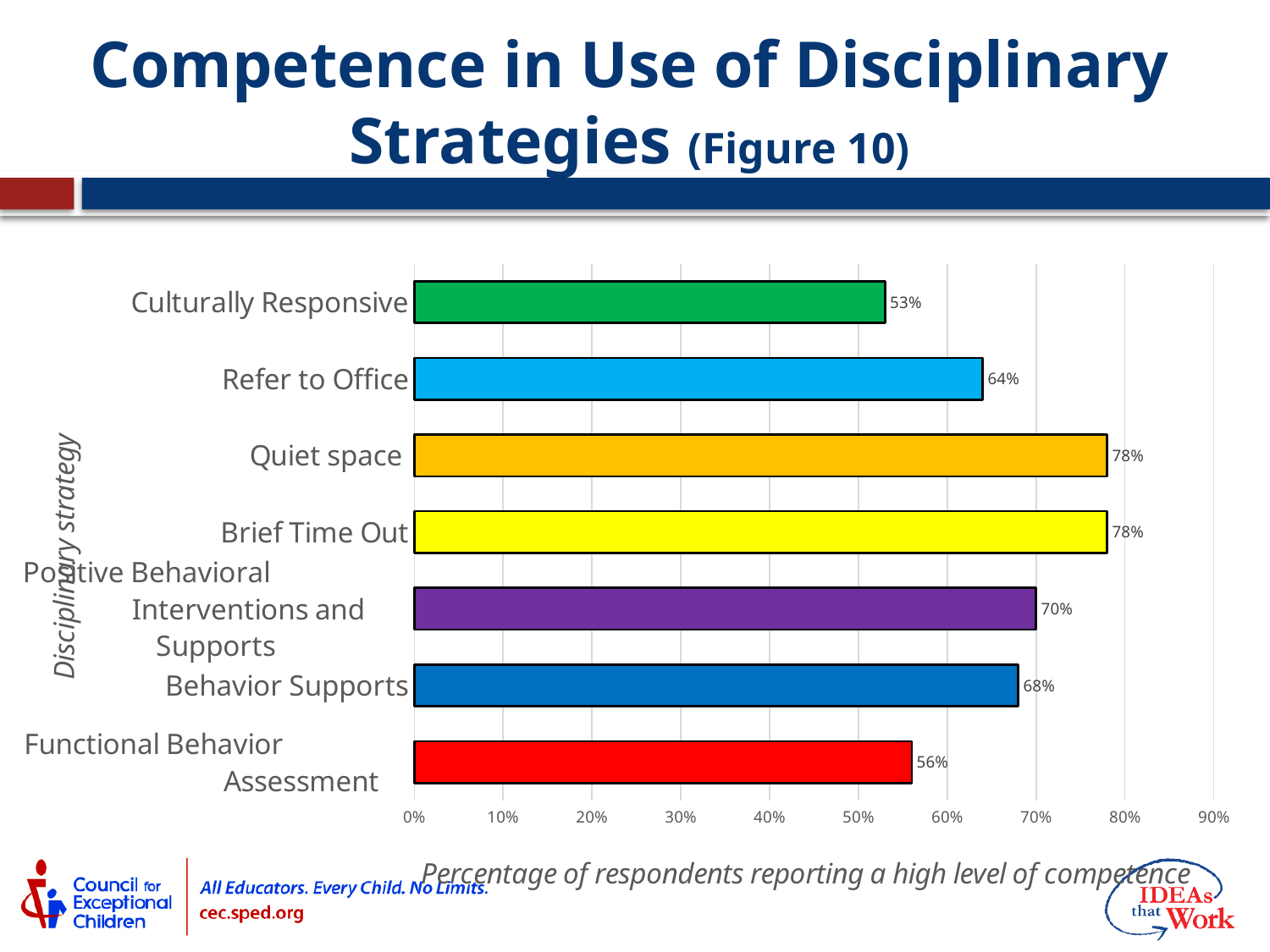
What is the label on the vertical axis of the chart? Disciplinary strategy What is the value for Refer to Office? 64% Which has a larger value, Positive Behavioral Interventions and Supports or Behavior Supports? Positive Behavioral Interventions and Supports Is the value for Functional Behavior Assessment greater or less than 60%? less What is the value for Behavior Supports? 68% What is the value for Functional Behavior Assessment? 56% What is the value for Quiet space? 78% How many disciplinary strategies are shown in the chart? 7 What is the difference between the values for Brief Time Out and Refer to Office? 14% Which disciplinary strategy has the lowest percentage of respondents reporting a high level of competence? Culturally Responsive What percentage of respondents reported a high level of competence for Culturally Responsive? 53% What kind of chart is shown on the slide? Bar chart